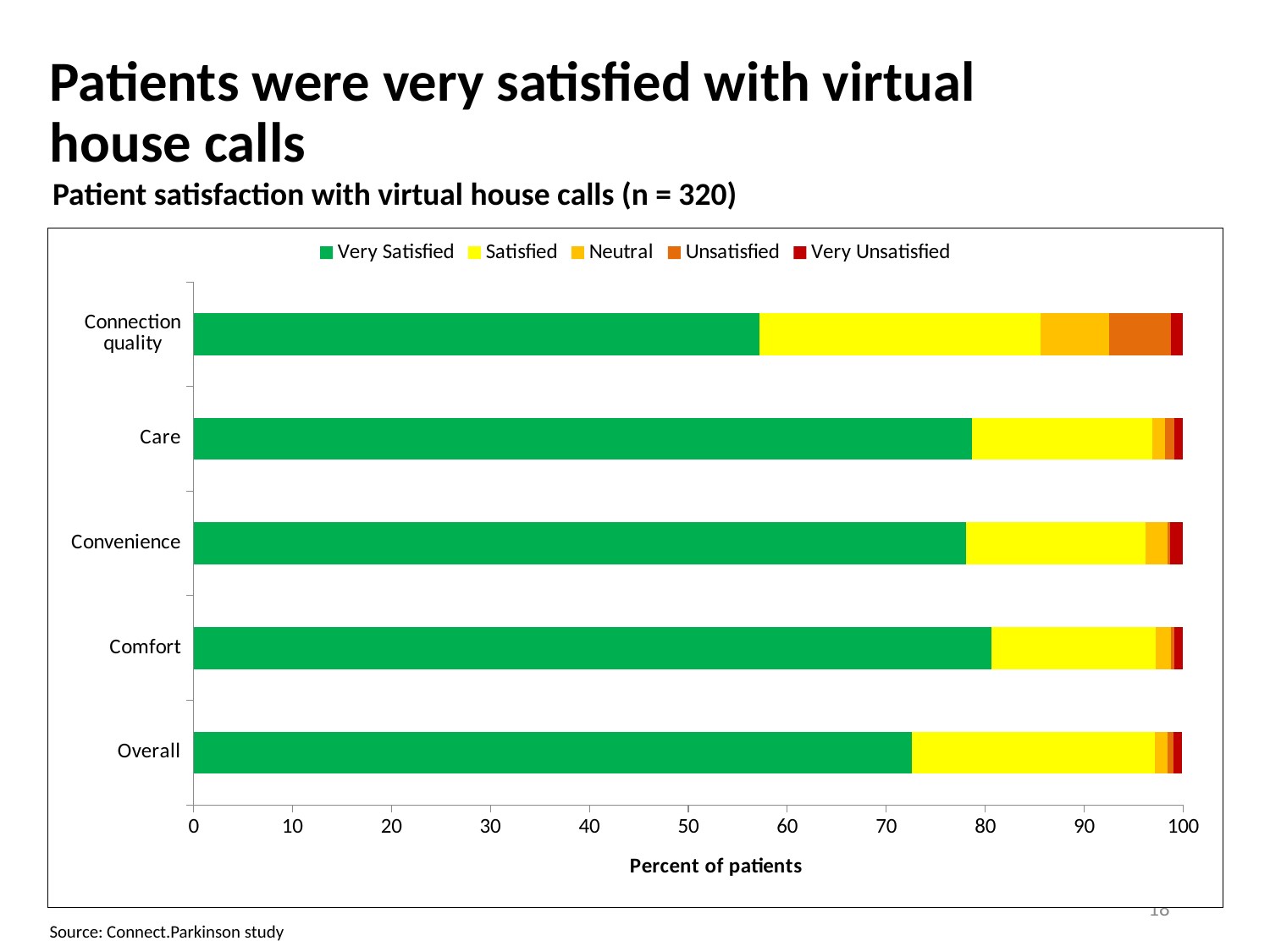
How many series does the chart's legend list? 5 Is the Very Satisfied value for Connection quality greater or less than 60? less Is the Very Satisfied value for Care greater or less than 70? greater Which category has the largest Unsatisfied segment? Connection quality Which has a larger Very Satisfied share, Connection quality or Overall? Overall Which category has the smallest Very Satisfied segment? Connection quality What is the title of the chart's horizontal axis? Percent of patients How many categories are shown on the vertical axis of the chart? 5 What is the title of the chart? Patient satisfaction with virtual house calls (n = 320) What kind of chart is shown on the slide? Stacked bar chart Is the Very Satisfied value for Overall greater or less than 70? greater Which category has the largest Neutral segment? Connection quality